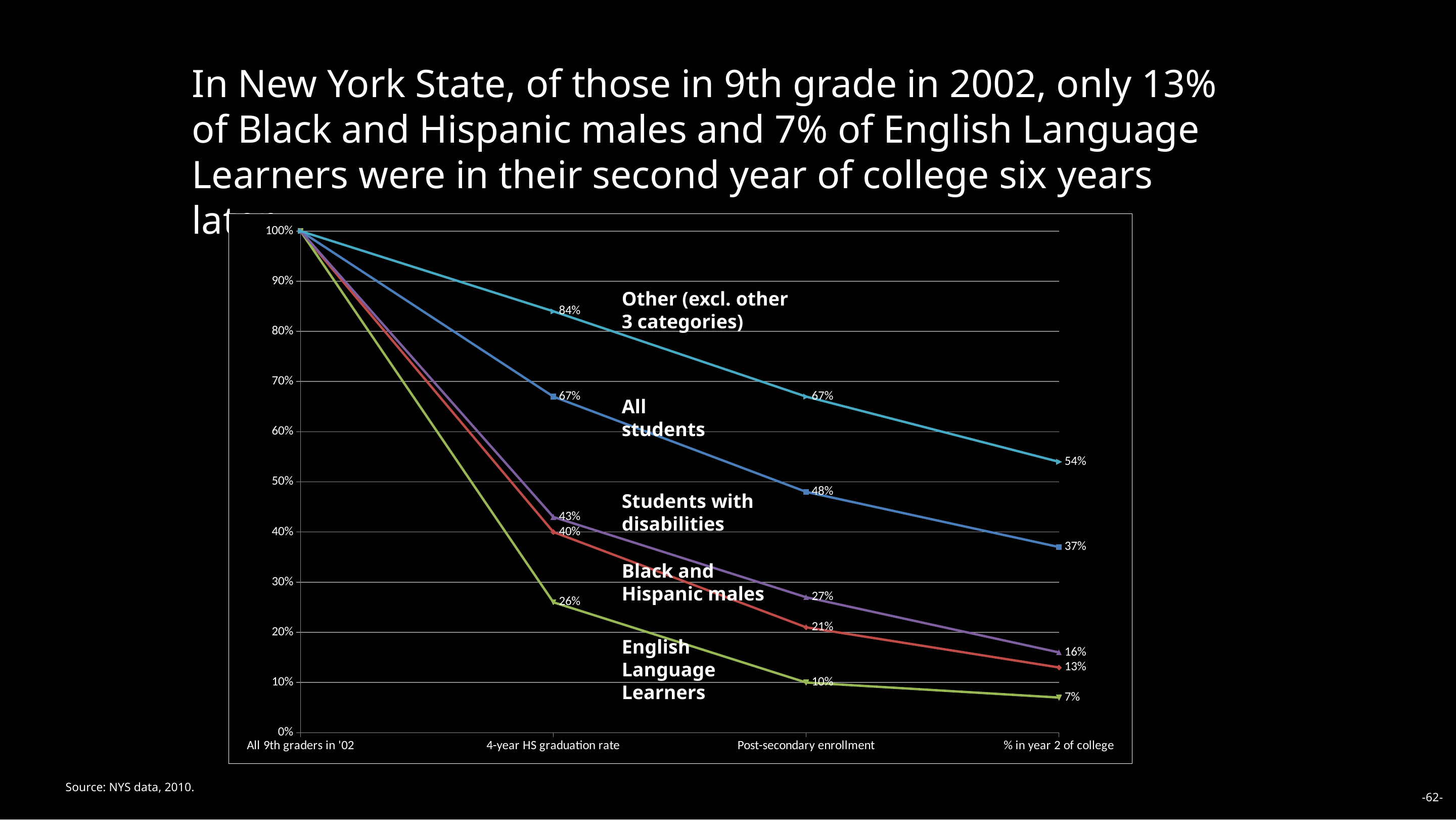
What is the value for All students at Post-secondary enrollment? 48% Which group has the lowest value at % in year 2 of college? English Language Learners At Post-secondary enrollment, which is larger: Students with disabilities or Black and Hispanic males? Students with disabilities What is the value for Students with disabilities at % in year 2 of college? 16% What is the 4-year HS graduation rate for the Other (excl. other 3 categories) group? 84% How many lines (groups) are plotted on the chart? 5 What is the 4-year HS graduation rate for English Language Learners? 26% What kind of chart is shown on the slide? line chart Which group has the highest value at Post-secondary enrollment? Other (excl. other 3 categories) What is the difference between the Other (excl. other 3 categories) group and All students at % in year 2 of college? 17% How many categories are shown on the x axis? 4 Do the values for All students rise or fall from left to right along the x axis? fall